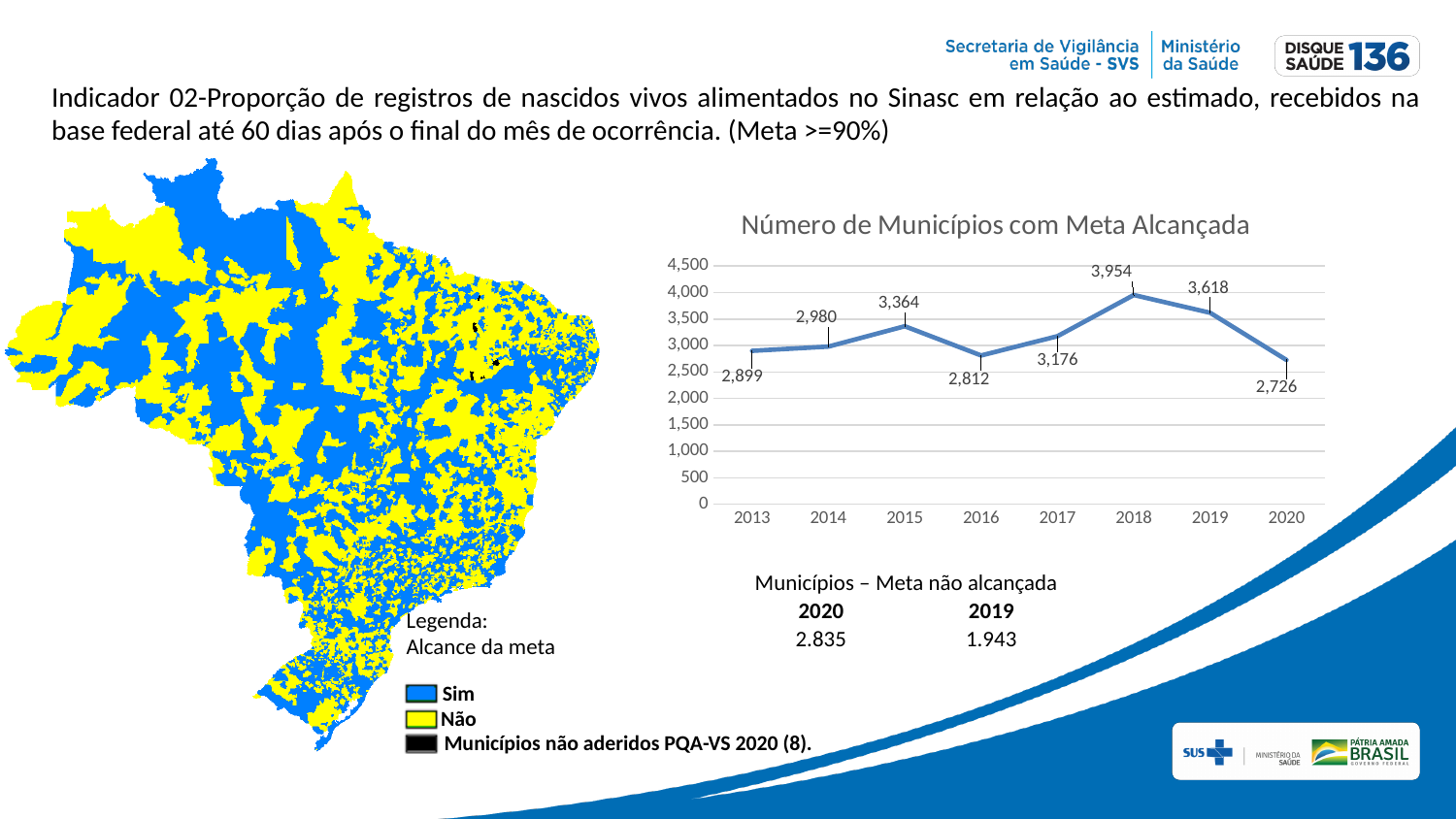
In the chart "Número de Municípios com Meta Alcançada", what is the difference between the values for 2015 and 2016? 552 In the chart "Número de Municípios com Meta Alcançada", what is the difference between the values for 2018 and 2019? 336 In the chart "Número de Municípios com Meta Alcançada", what is the value for 2013? 2,899 In the chart "Número de Municípios com Meta Alcançada", which is larger, the value for 2014 or the value for 2017? 2017 In the chart "Número de Municípios com Meta Alcançada", does the value rise or fall from 2019 to 2020? fall In the chart "Número de Municípios com Meta Alcançada", which year has the lowest value? 2020 In the chart "Número de Municípios com Meta Alcançada", which year has the highest value? 2018 What type of chart is "Número de Municípios com Meta Alcançada"? line chart How many years are plotted in the chart "Número de Municípios com Meta Alcançada"? 8 In the chart "Número de Municípios com Meta Alcançada", what is the value for 2018? 3,954 In the chart "Número de Municípios com Meta Alcançada", what is the value for 2020? 2,726 In the chart "Número de Municípios com Meta Alcançada", is the value for 2018 greater or less than 3,500? greater